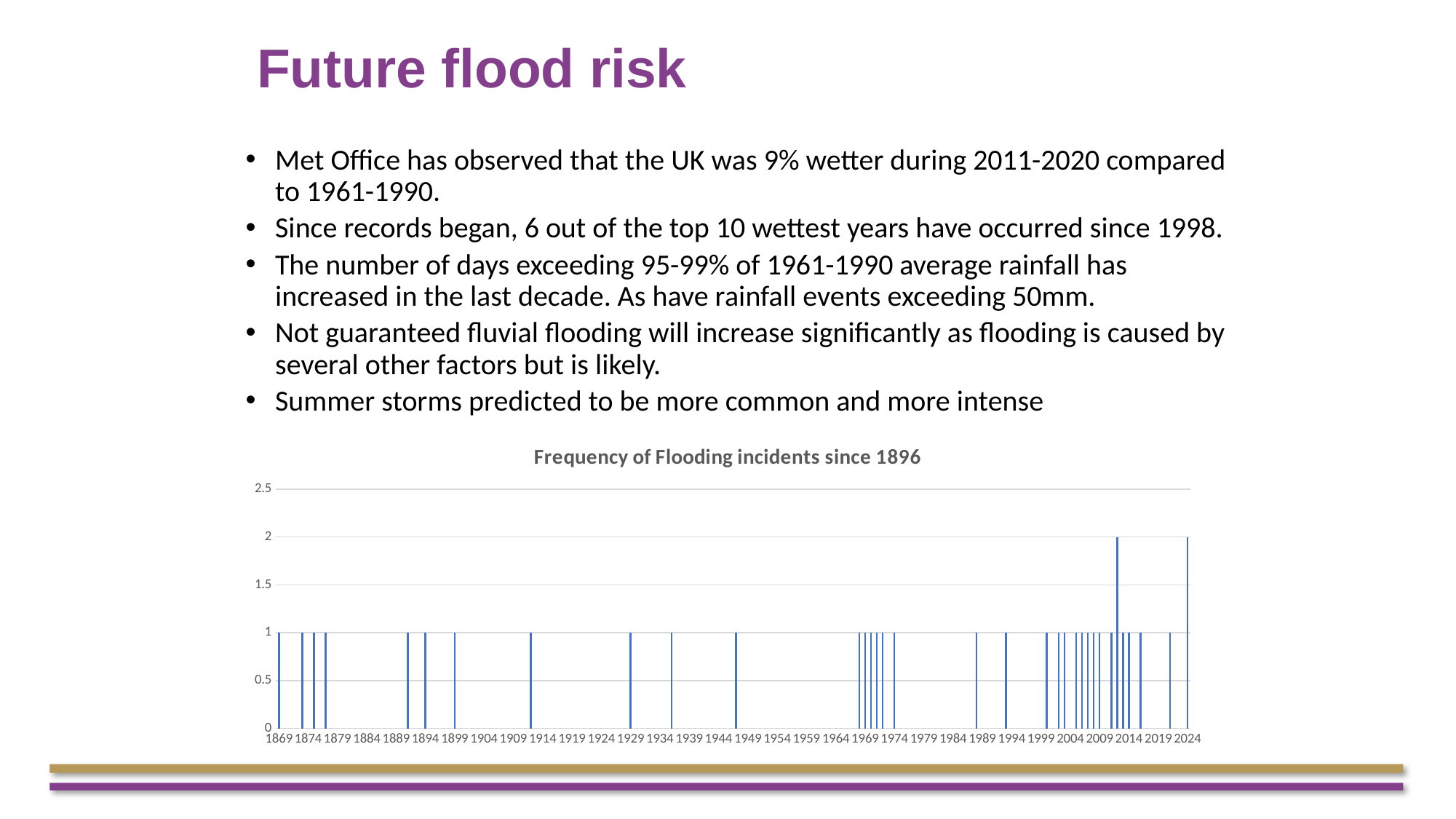
Is the value for 1869 greater or less than 1.5? less Which has the larger value, 1869 or 2024? 2024 What is the difference between the value for 2024 and the value for 1869? 1 What is the title of the chart? Frequency of Flooding incidents since 1896 What is the highest value reached by any bar in the chart? 2 Do flooding incidents become more or less frequent toward the right-hand end of the x axis? More frequent What kind of chart is shown on the slide? Bar chart How many bars in the chart reach a value of 2? 2 What is the highest tick value shown on the y axis? 2.5 What is the value for 1869 in the chart? 1 What is the value for 2024 in the chart? 2 Is the value for 2024 greater or less than 1.5? greater